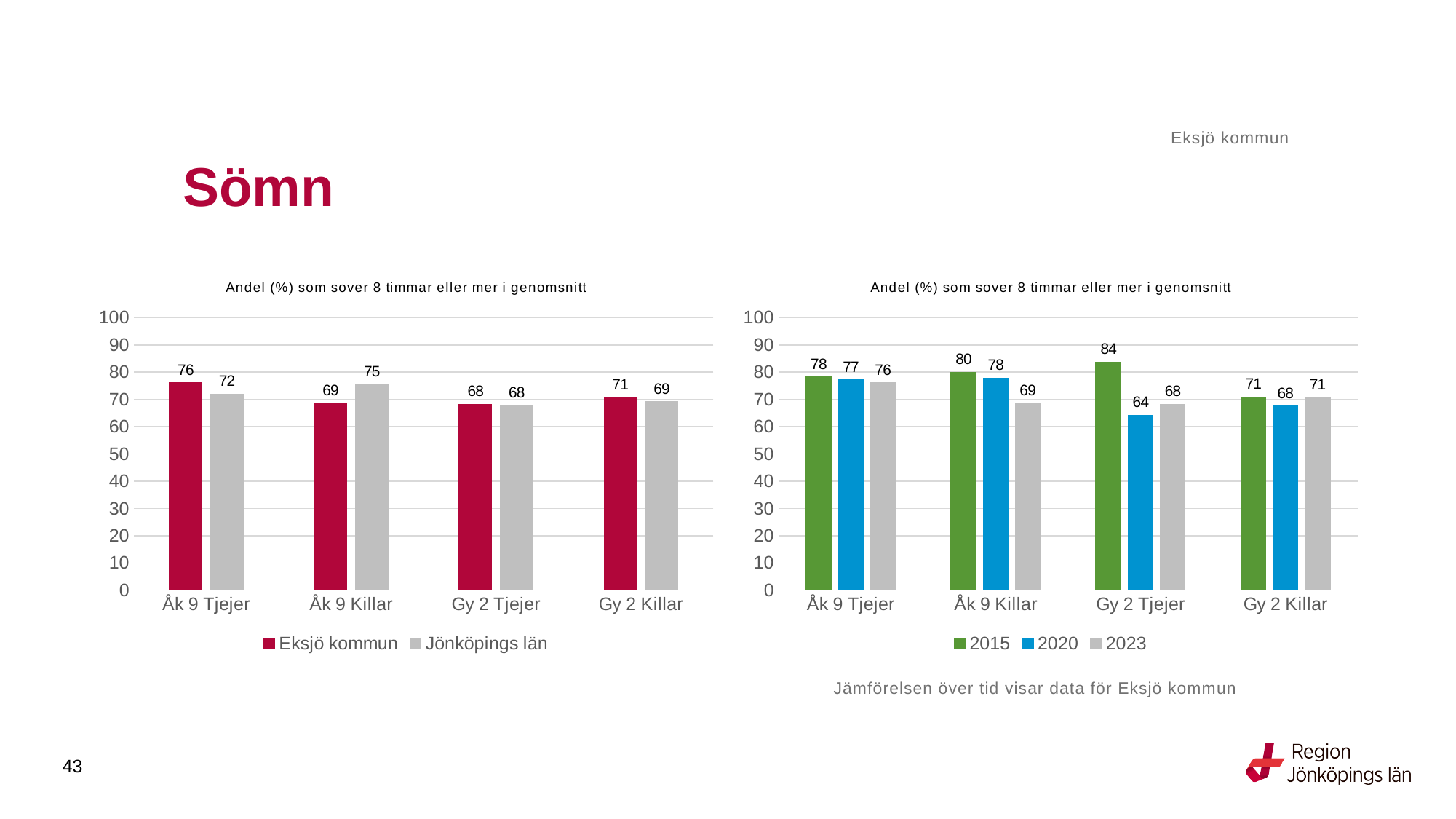
In the left chart, what is the value for Eksjö kommun for Åk 9 Tjejer? 76 In the right chart, what is the value for 2015 for Gy 2 Tjejer? 84 In the right chart, which category has the lowest value for 2020? Gy 2 Tjejer How many series does the legend of the left chart list? 2 What kind of chart is the right chart? Bar chart In the right chart, what is the difference between the 2015 and 2023 values for Gy 2 Tjejer? 16 In the right chart, what is the value for 2020 for Åk 9 Killar? 78 In the left chart, what is the difference between Eksjö kommun and Jönköpings län for Åk 9 Killar? 6 In the left chart, what is the value for Jönköpings län for Åk 9 Killar? 75 In the right chart, how many categories are shown on the x axis? 4 In the left chart, which is larger for Gy 2 Killar: Eksjö kommun or Jönköpings län? Eksjö kommun In the left chart, which category has the highest value for Eksjö kommun? Åk 9 Tjejer